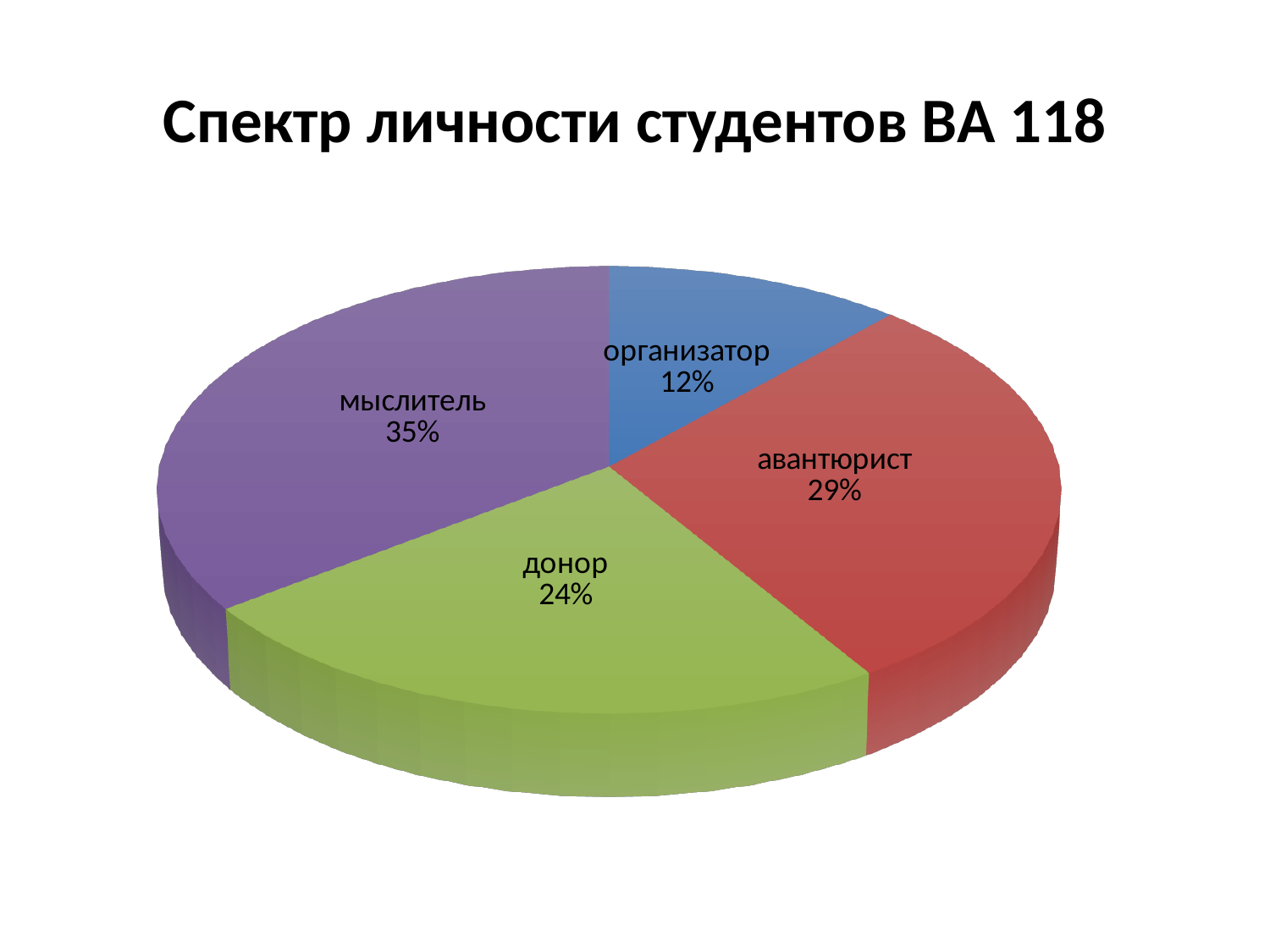
What is the title of the slide? Спектр личности студентов ВА 118 Which is larger, the share for 'авантюрист' or the share for 'донор'? авантюрист What is the value shown for 'организатор'? 12% What kind of chart is shown on the slide? pie chart What is the value shown for 'авантюрист'? 29% What share of the pie does the 'мыслитель' slice represent? 35% What colour is the 'донор' slice? green Which category has the largest slice of the pie? мыслитель What is the value shown for 'донор'? 24% What is the difference between the shares of 'мыслитель' and 'организатор'? 23% How many slices does the pie chart have? 4 Which category has the smallest slice of the pie? организатор